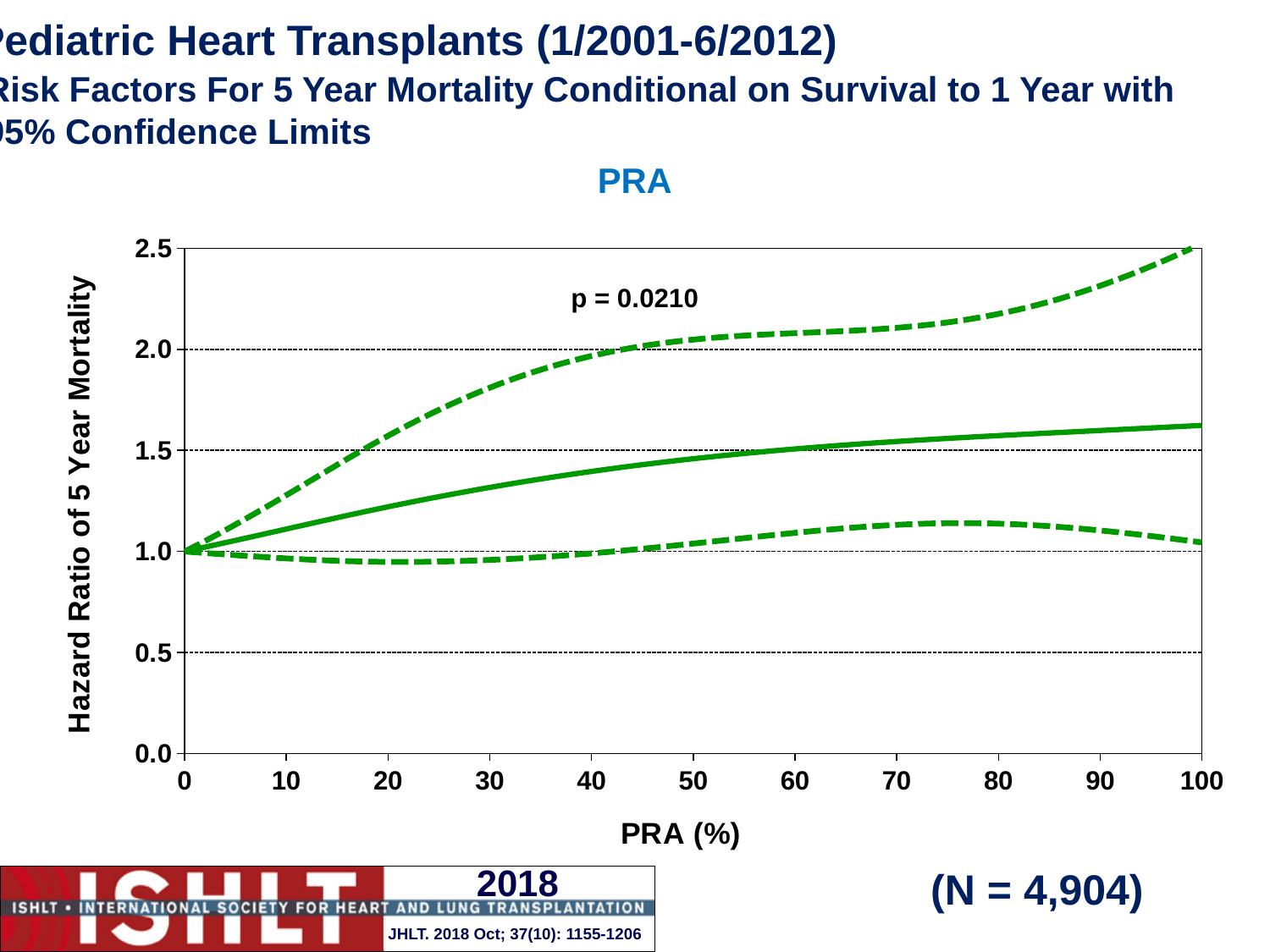
How many lines are plotted on the chart? 3 Is the value of the solid hazard ratio line at PRA 100% greater or less than 1.5? greater Is the value of the upper dashed confidence limit at PRA 80% greater or less than 2.0? greater Is the value of the upper dashed confidence limit at PRA 30% greater or less than 2.0? less What kind of chart is shown on the slide? line chart Which is larger at PRA 50%: the solid hazard ratio line or the upper dashed confidence limit? the upper dashed confidence limit What p-value is printed on the chart? p = 0.0210 What is the hazard ratio of the solid line at PRA 0%? 1.0 What is the title of the chart? PRA Does the solid hazard ratio line rise or fall as PRA (%) increases from 0 to 100? rise